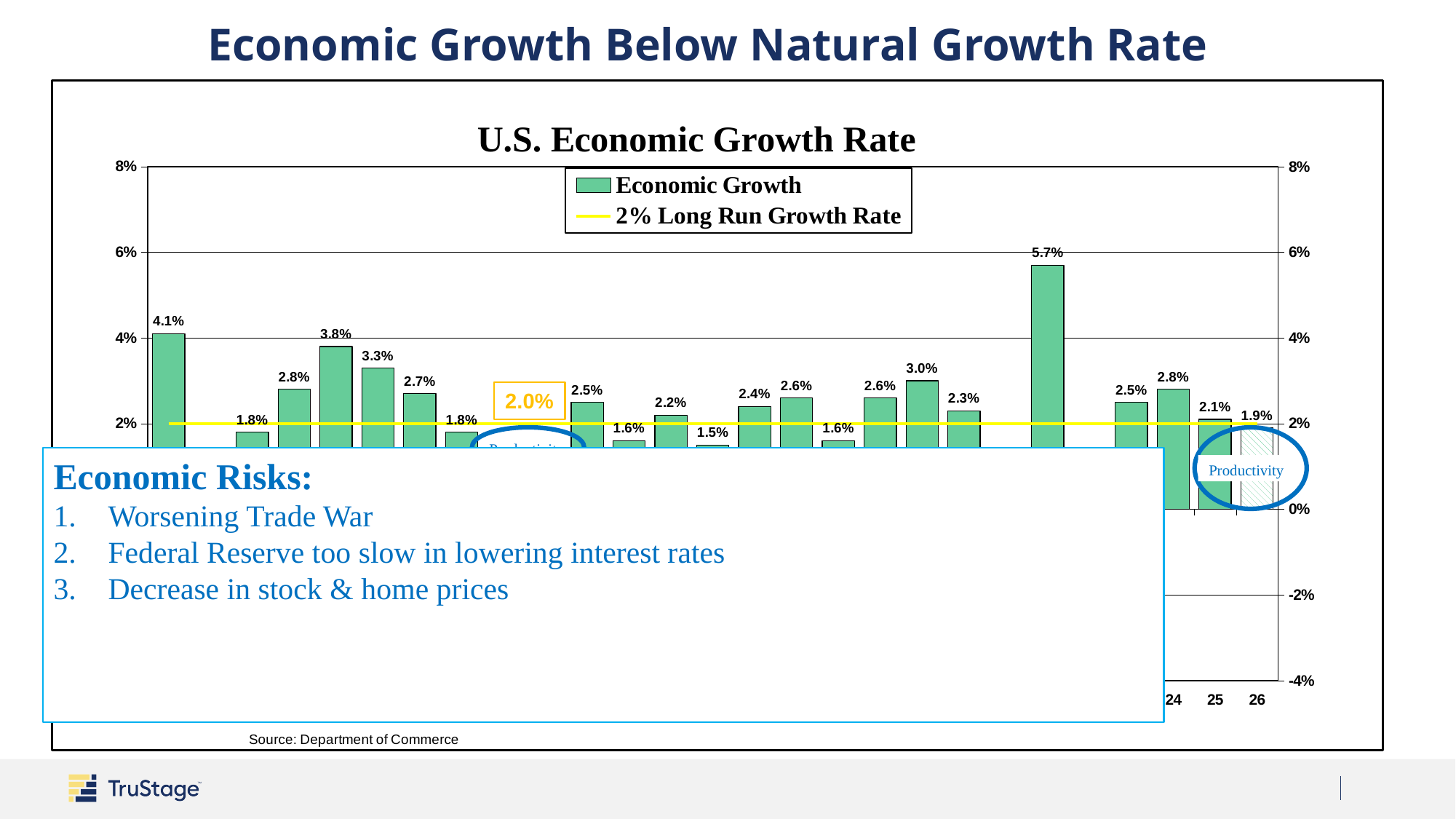
What is the Economic Growth value for the year labeled 24? 2.8% What is the Economic Growth value for the year labeled 26? 1.9% What is the difference between the Economic Growth values for years 24 and 26? 0.9% What kind of chart is used to show Economic Growth in the U.S. Economic Growth Rate chart? Bar chart What is the Economic Growth value for the year labeled 25? 2.1% What source is cited for the U.S. Economic Growth Rate chart? Department of Commerce Is the Economic Growth value for year 26 greater or less than 2%? less What is the highest value shown by the Economic Growth bars in the U.S. Economic Growth Rate chart? 5.7% At what level is the Long Run Growth Rate line drawn in the chart? 2% Which year has the larger Economic Growth value, 24 or 25? 24 How many series does the legend of the U.S. Economic Growth Rate chart list? 2 What is the title of the chart on the slide? U.S. Economic Growth Rate